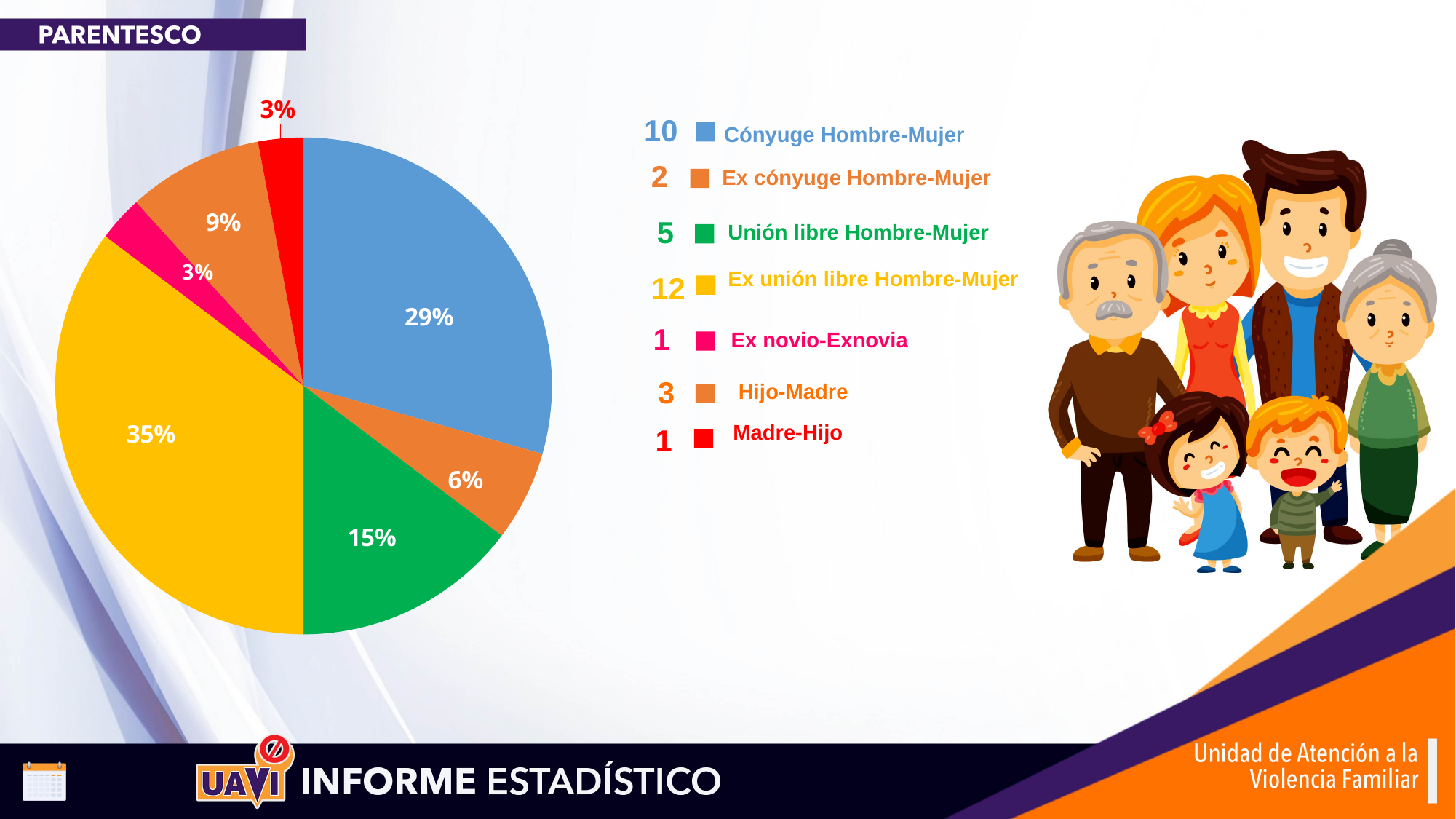
What colour is the slice for Ex novio-Exnovia? pink What type of chart is shown on the slide? pie chart What percentage of the pie does Cónyuge Hombre-Mujer represent? 29% What percentage of the pie does Ex unión libre Hombre-Mujer represent? 35% What is the difference in percentage points between the Ex unión libre Hombre-Mujer slice and the Cónyuge Hombre-Mujer slice? 6 What is the title shown above the pie chart? PARENTESCO What percentage of the pie does Unión libre Hombre-Mujer represent? 15% What count is listed in the legend for Hijo-Madre? 3 Which category has the largest share of the pie? Ex unión libre Hombre-Mujer How many categories does the pie chart have? 7 Which is larger, the share for Cónyuge Hombre-Mujer or the share for Unión libre Hombre-Mujer? Cónyuge Hombre-Mujer What count is listed in the legend for Ex unión libre Hombre-Mujer? 12